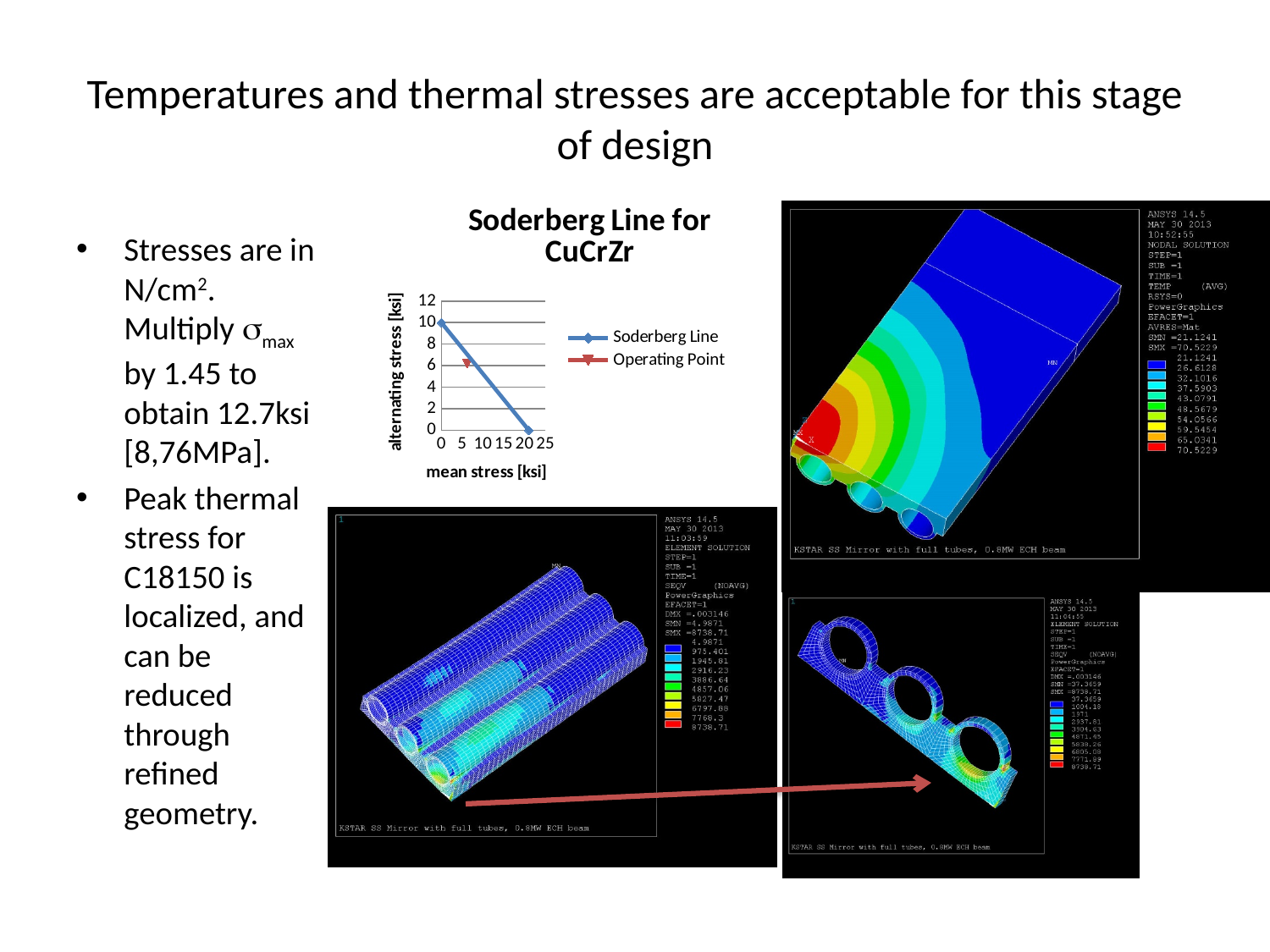
How many series does the legend of the Soderberg Line chart list? 2 In the Soderberg Line chart, is the alternating stress of the Operating Point greater or less than 4? greater What is the title of the chart on the slide? Soderberg Line for CuCrZr What kind of chart is the Soderberg Line for CuCrZr chart? line chart What are the two series named in the legend of the Soderberg Line chart? Soderberg Line and Operating Point In the Soderberg Line chart, is the Operating Point above or below the Soderberg Line? below In the Soderberg Line chart, is the alternating stress of the Operating Point greater or less than 8? less In the Soderberg Line chart, does the Soderberg Line rise or fall as mean stress increases? fall What is the highest value shown on the y axis of the Soderberg Line chart? 12 In the Soderberg Line chart, is the mean stress of the Operating Point greater or less than 10? less In the Soderberg Line chart, what is the alternating stress of the Soderberg Line at a mean stress of 0 ksi? 10